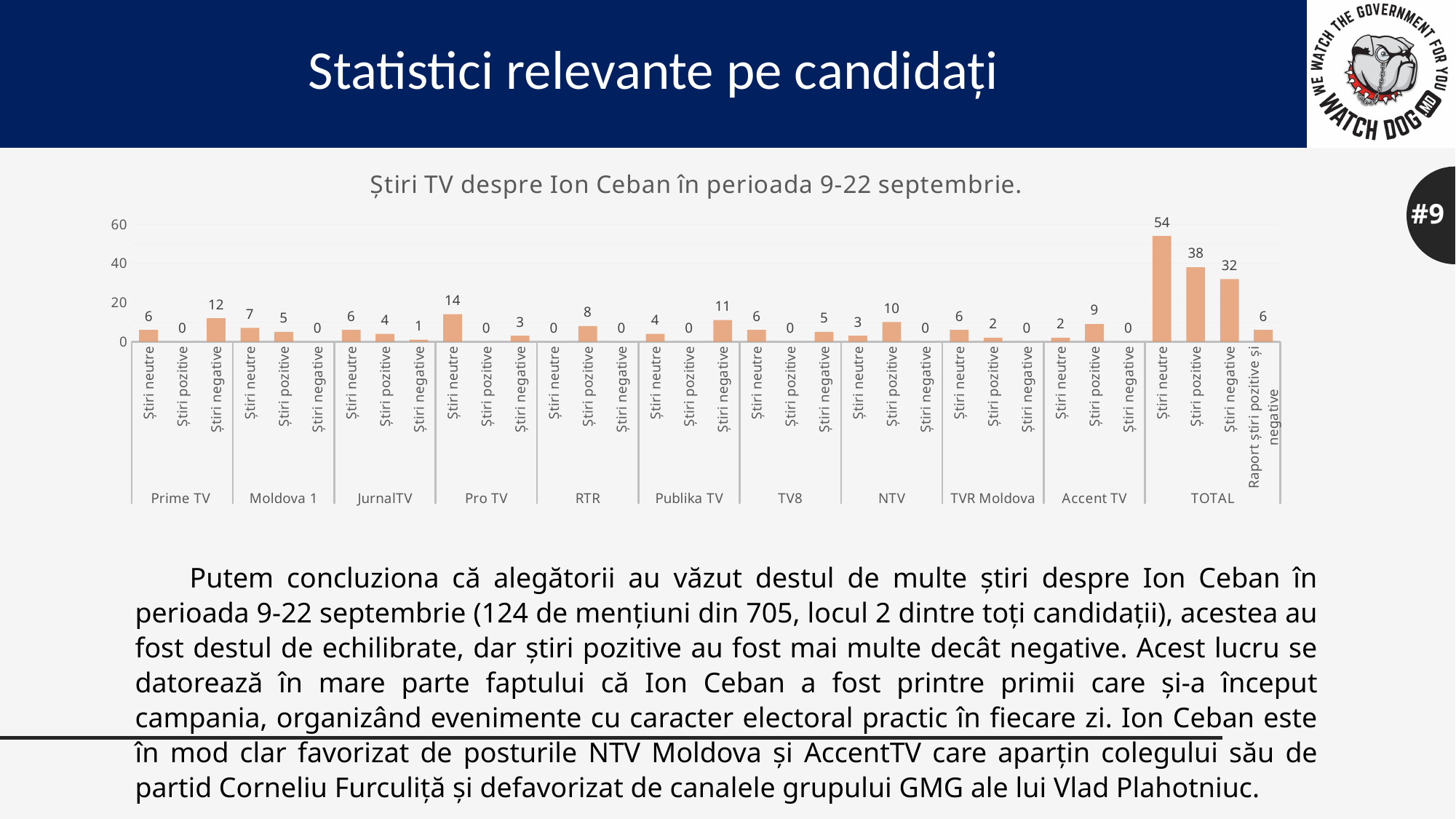
Is the value for Știri neutre in the TOTAL group greater or less than 40? greater What is the difference between Știri pozitive and Știri negative in the TOTAL group? 6 What is the value for Știri negative at Prime TV? 12 What is the value for Știri pozitive at RTR? 8 What is the title of the chart? Știri TV despre Ion Ceban în perioada 9-22 septembrie. Which is larger: Știri negative at Publika TV or Știri pozitive at Accent TV? Știri negative at Publika TV How many TV station groups (including TOTAL) are shown on the x axis? 11 Which bar in the TOTAL group has the highest value? Știri neutre What kind of chart is shown on the slide? Bar chart What is the value for Știri pozitive at NTV? 10 What is the value for Știri neutre at Pro TV? 14 What is the value for Știri neutre in the TOTAL group? 54